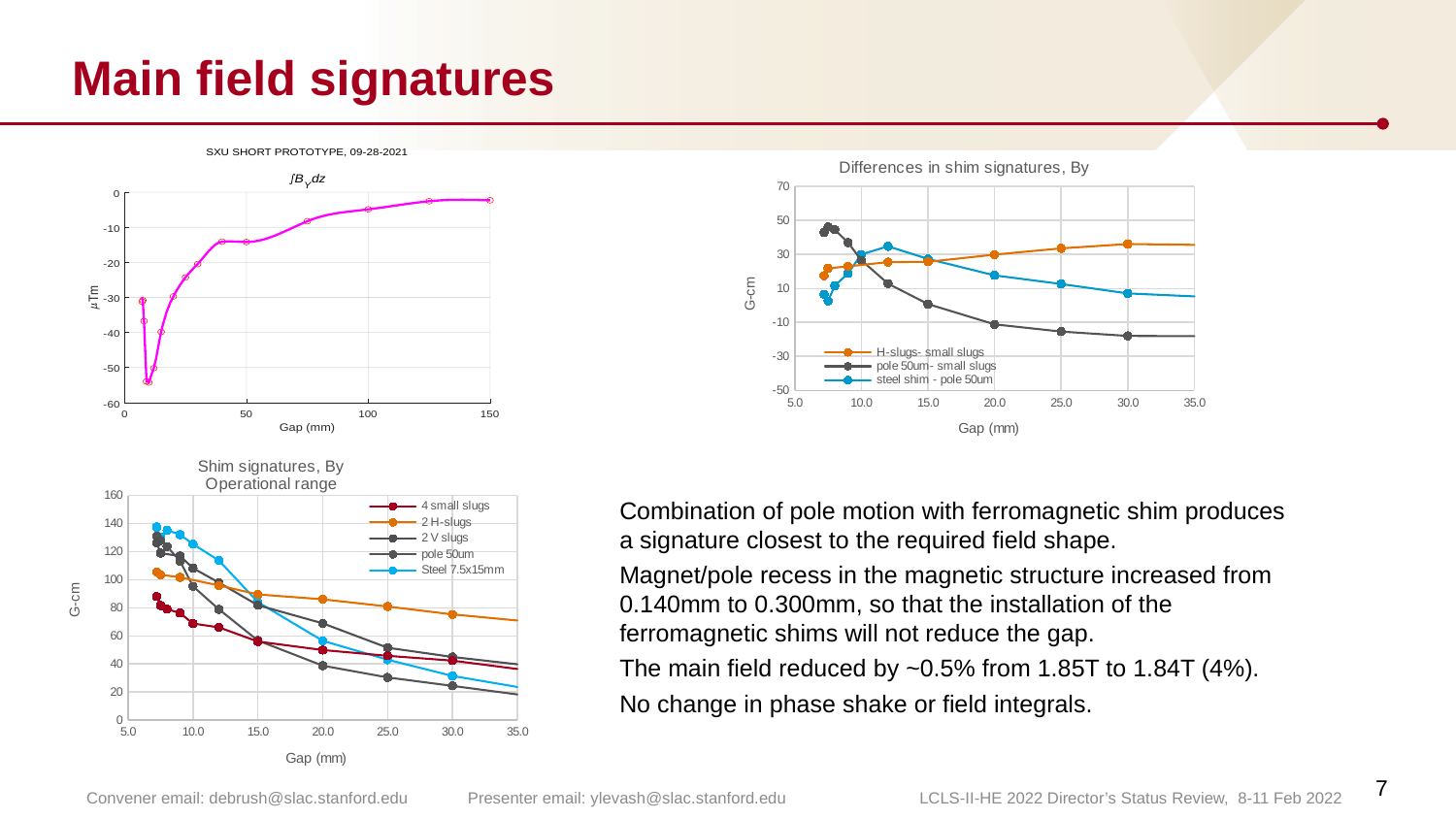
How many series does the legend of the "Differences in shim signatures, By" chart list? 3 In the "Differences in shim signatures, By" chart, does the pole 50um- small slugs series rise or fall as the gap increases from 10.0 to 30.0? fall What kind of chart is the "Differences in shim signatures, By" chart? line chart In the "Differences in shim signatures, By" chart, does the H-slugs- small slugs series rise or fall as the gap increases from 10.0 to 30.0? rise In the "Differences in shim signatures, By" chart, is the value for H-slugs- small slugs at gap 30.0 greater or less than 20? greater In the "Shim signatures, By Operational range" chart, at gap 20.0, which is larger: 2 H-slugs or 4 small slugs? 2 H-slugs In the "Shim signatures, By Operational range" chart, is the value for Steel 7.5x15mm at gap 30.0 greater or less than 40? less How many series does the legend of the "Shim signatures, By Operational range" chart list? 5 In the "Shim signatures, By Operational range" chart, which series has the highest value at gap 35.0? 2 H-slugs In the "Differences in shim signatures, By" chart, at gap 35.0, which is larger: H-slugs- small slugs or steel shim - pole 50um? H-slugs- small slugs In the top-left "SXU SHORT PROTOTYPE, 09-28-2021" chart, is the value at gap 50 greater or less than -10? less What is the y-axis label of the top-left "SXU SHORT PROTOTYPE, 09-28-2021" chart? µTm